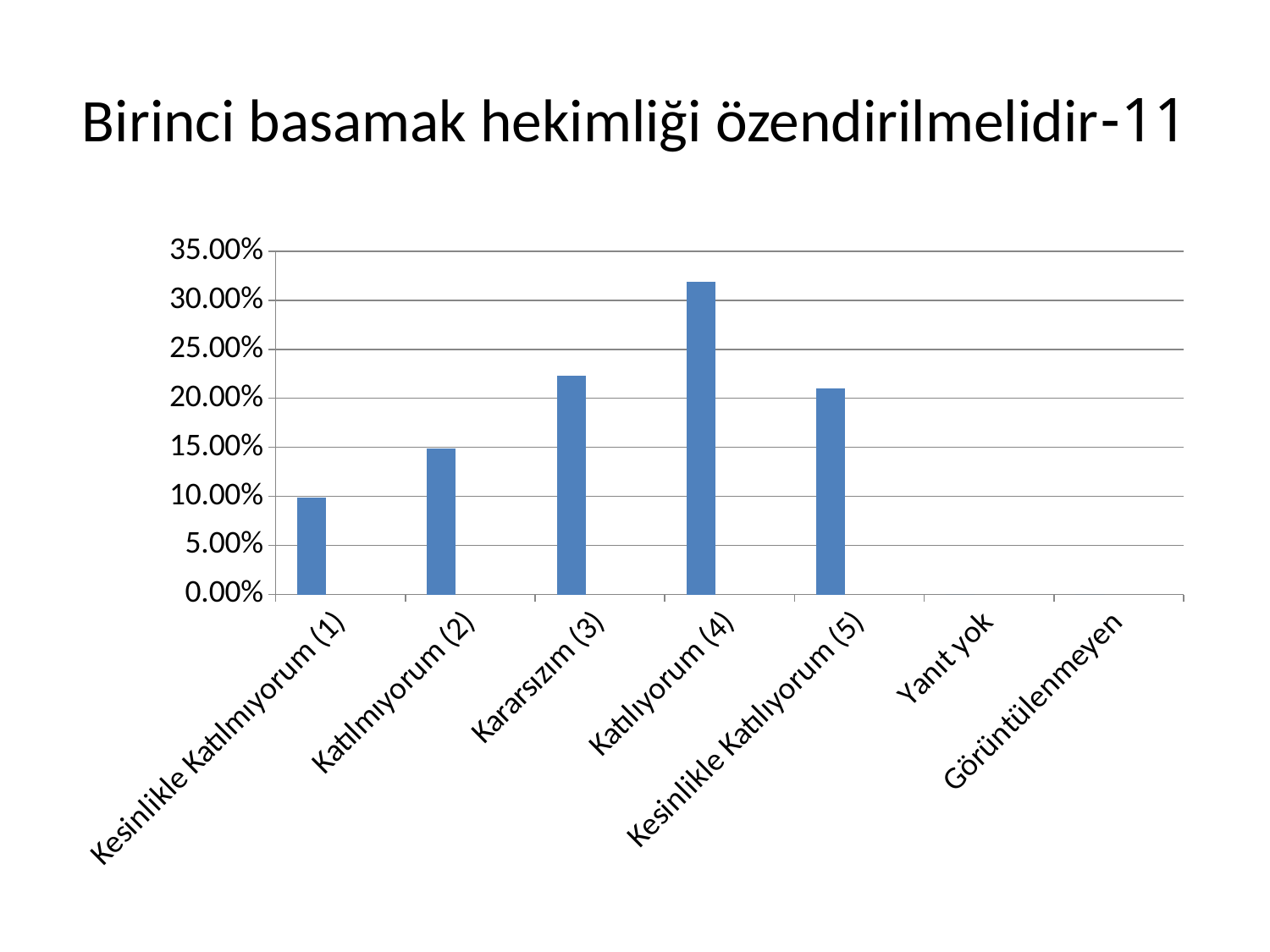
Is the value for Kesinlikle Katılıyorum (5) greater or less than 25.00%? less Do the values rise or fall along the x axis from Kesinlikle Katılmıyorum (1) to Katılıyorum (4)? rise What is the title of the chart on the slide? Birinci basamak hekimliği özendirilmelidir-11 How many categories are shown on the x axis of the chart? 7 Is the value for Kararsızım (3) greater or less than 20.00%? greater Which is larger, the value for Katılmıyorum (2) or the value for Kesinlikle Katılmıyorum (1)? Katılmıyorum (2) Is the value for Katılıyorum (4) greater or less than 30.00%? greater Among the categories with a visible bar, which one has the lowest value? Kesinlikle Katılmıyorum (1) What kind of chart is shown on the slide? bar chart Which category has the highest bar in the chart? Katılıyorum (4)